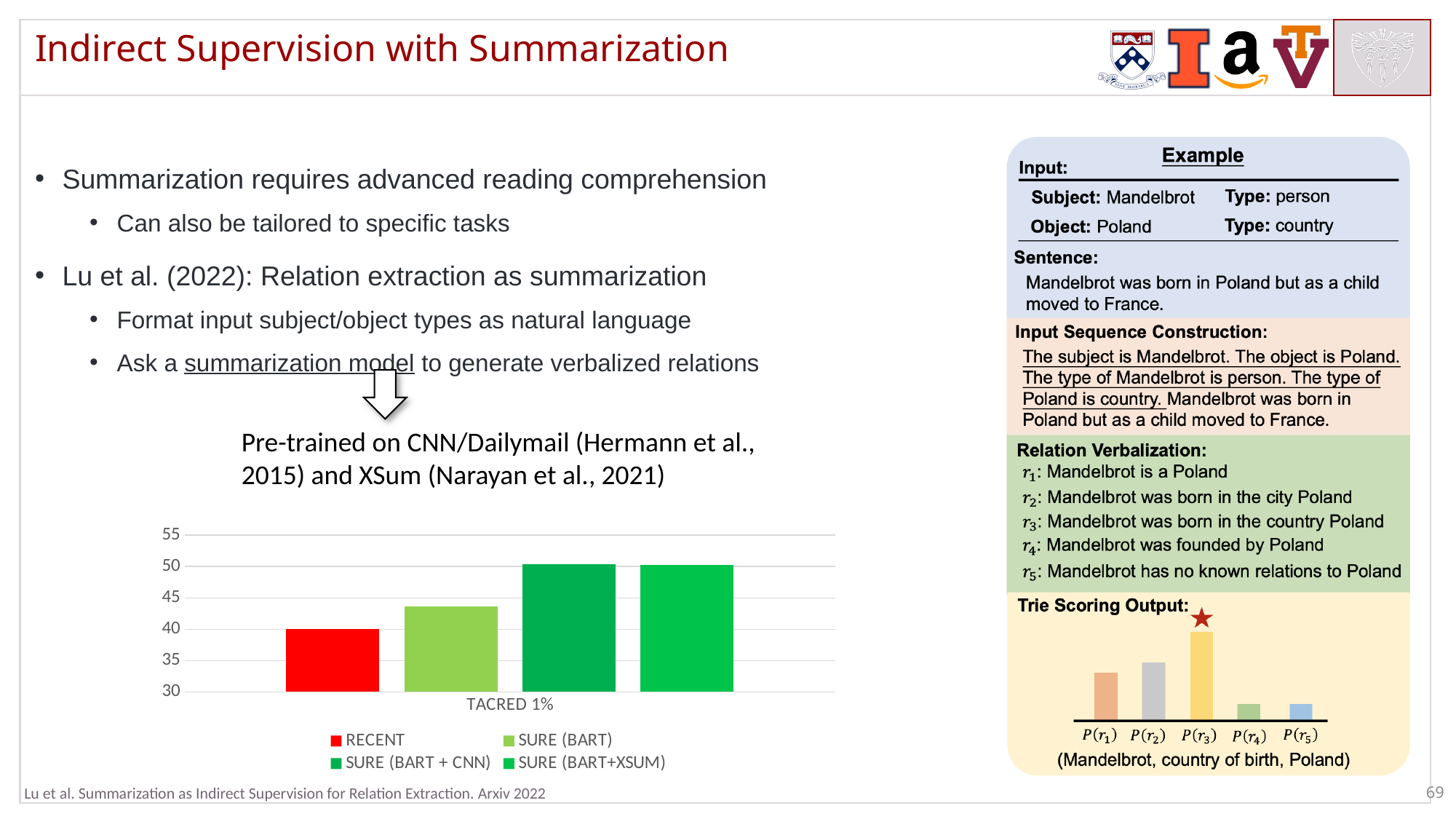
Which is larger in the bar chart, SURE (BART) or SURE (BART + CNN)? SURE (BART + CNN) Is the value for SURE (BART + CNN) in the bar chart greater or less than 45? greater Is the value for RECENT in the bar chart greater or less than 45? less What colour is the RECENT series in the bar chart legend? red Is the value for SURE (BART) in the bar chart greater or less than 45? less Which series has the lowest value in the bar chart? RECENT What is the category label on the x axis of the bar chart? TACRED 1% How many series does the legend of the bar chart list? 4 Which is larger in the bar chart, RECENT or SURE (BART)? SURE (BART) How many categories are shown on the x axis of the bar chart? 1 What kind of chart is shown on the left of the slide? bar chart